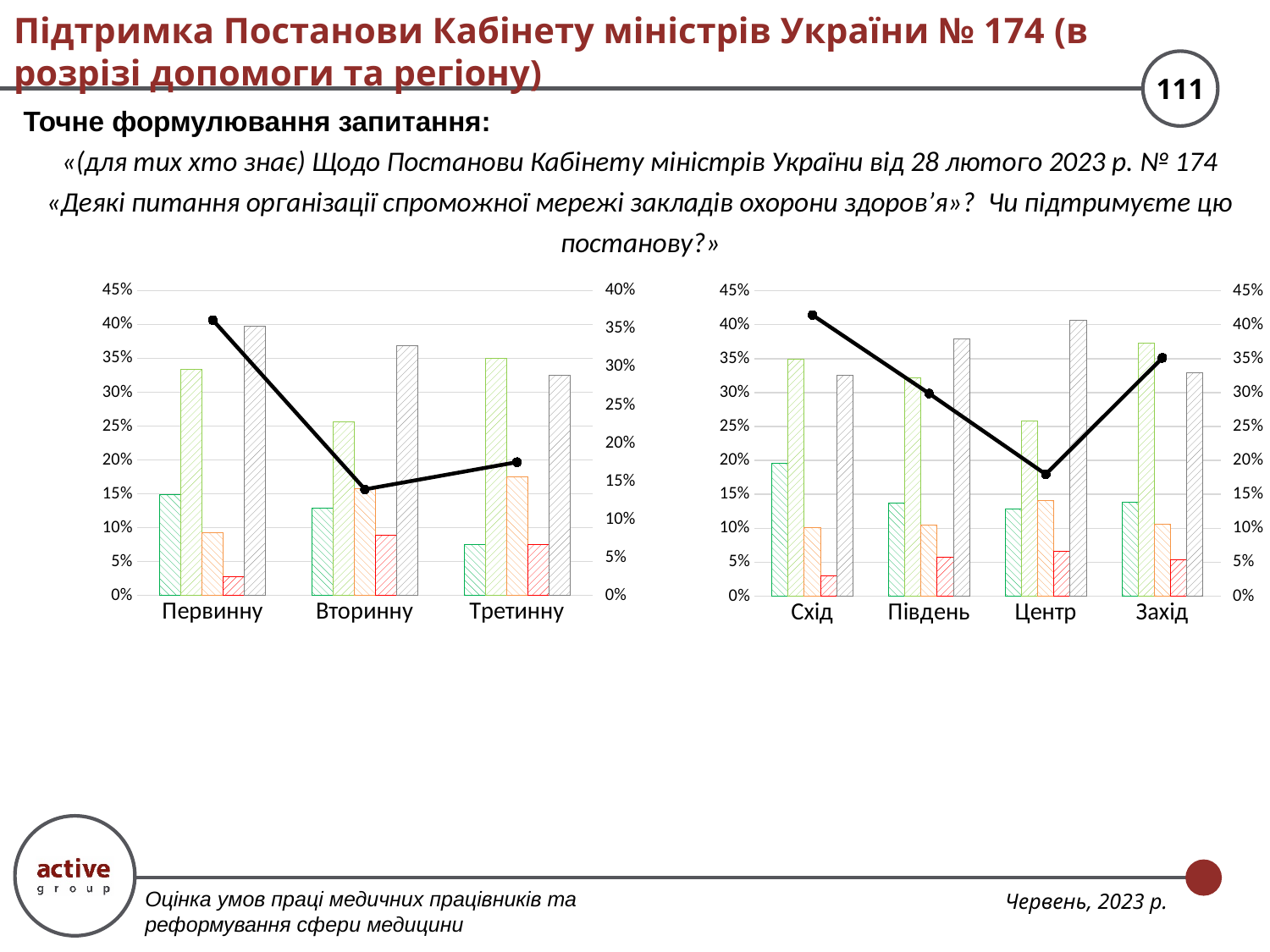
In the right chart, is the black line value for Центр greater or less than 20%? less In the right chart, does the black line rise or fall from Схід to Центр? fall In the left chart, is the black line value for Первинну greater or less than 30%? greater What kind of chart is the left chart? bar and line chart In the right chart, is the black line value for Захід greater or less than 30%? greater In the right chart, at which category does the black line reach its highest point? Схід In the left chart, at which category does the black line reach its highest point? Первинну In the left chart, at which category does the black line reach its lowest point? Вторинну In the right chart, how many categories are shown on the x axis? 4 In the right chart, at which category does the black line reach its lowest point? Центр In the left chart, how many categories are shown on the x axis? 3 How many charts are on the slide? 2